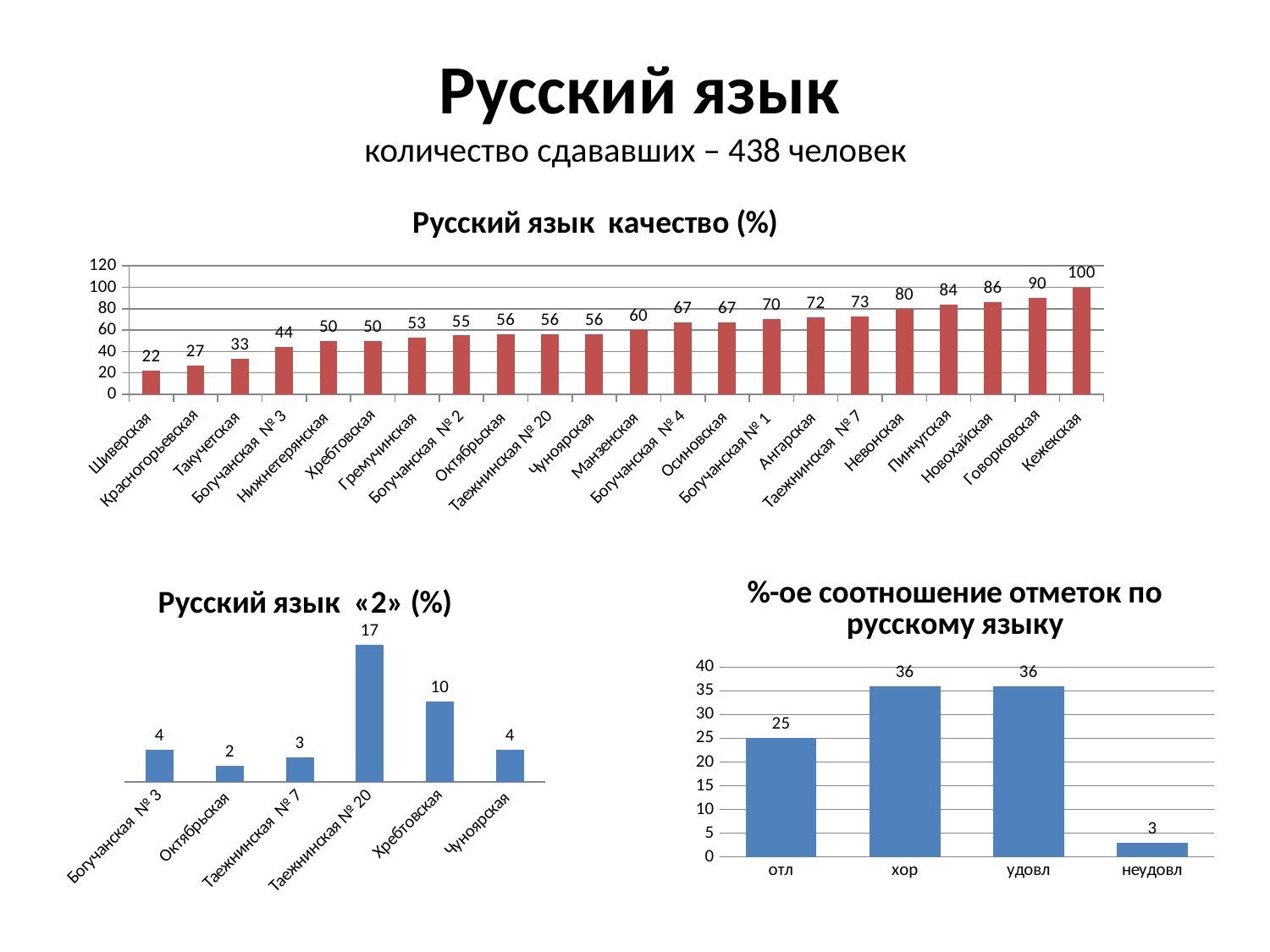
In the chart 'Русский язык «2» (%)', which is larger, the value for Октябрьская or the value for Таежнинская № 7? Таежнинская № 7 What kind of chart is the bottom-right chart '%-ое соотношение отметок по русскому языку'? bar chart In the chart '%-ое соотношение отметок по русскому языку', what is the value for отл? 25 In the chart 'Русский язык качество (%)', how many categories are shown on the x axis? 22 In the chart 'Русский язык качество (%)', which category has the lowest value? Шиверская In the chart 'Русский язык качество (%)', what is the value for Кежекская? 100 In the chart '%-ое соотношение отметок по русскому языку', which category has the lowest value? неудовл In the chart 'Русский язык «2» (%)', which category has the highest value? Таежнинская № 20 In the chart 'Русский язык качество (%)', what is the value for Невонская? 80 In the chart 'Русский язык «2» (%)', what is the value for Хребтовская? 10 In the chart 'Русский язык качество (%)', what is the difference between the values for Говорковская and Шиверская? 68 In the chart 'Русский язык качество (%)', do the values rise or fall from left to right along the x axis? rise